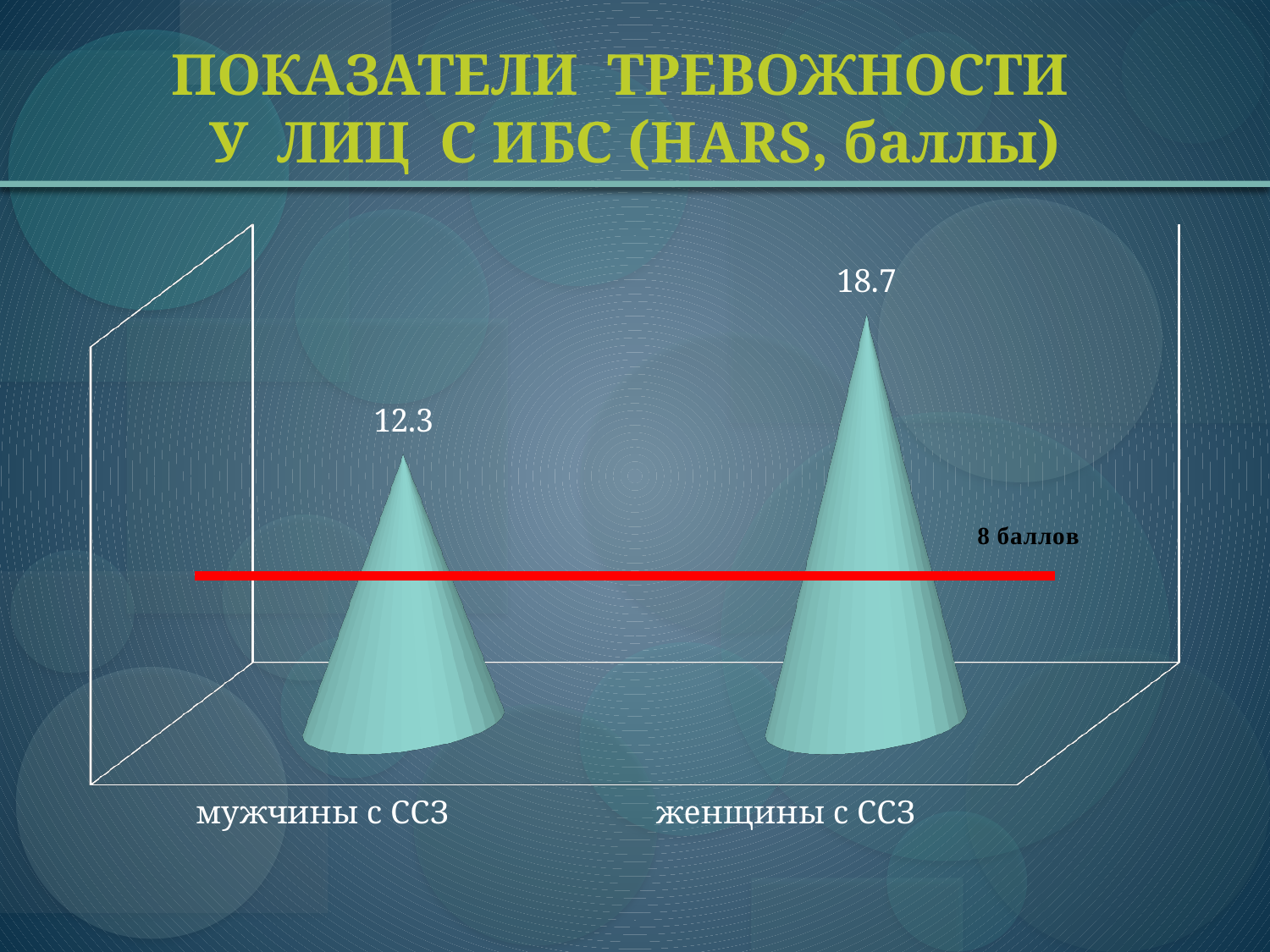
Which category has the highest value? женщины с ССЗ What is the value for женщины с ССЗ? 18.7 Do the values rise or fall from мужчины с ССЗ to женщины с ССЗ? rise What kind of chart is shown on the slide? bar chart Which is larger, the value for мужчины с ССЗ or the value for женщины с ССЗ? женщины с ССЗ What is the difference between the values for женщины с ССЗ and мужчины с ССЗ? 6.4 How many categories are shown in the chart? 2 What is the title of the chart on the slide? ПОКАЗАТЕЛИ ТРЕВОЖНОСТИ У ЛИЦ С ИБС (HARS, баллы) Which category has the lowest value? мужчины с ССЗ What level does the red horizontal line on the chart mark? 8 баллов What is the value for мужчины с ССЗ? 12.3